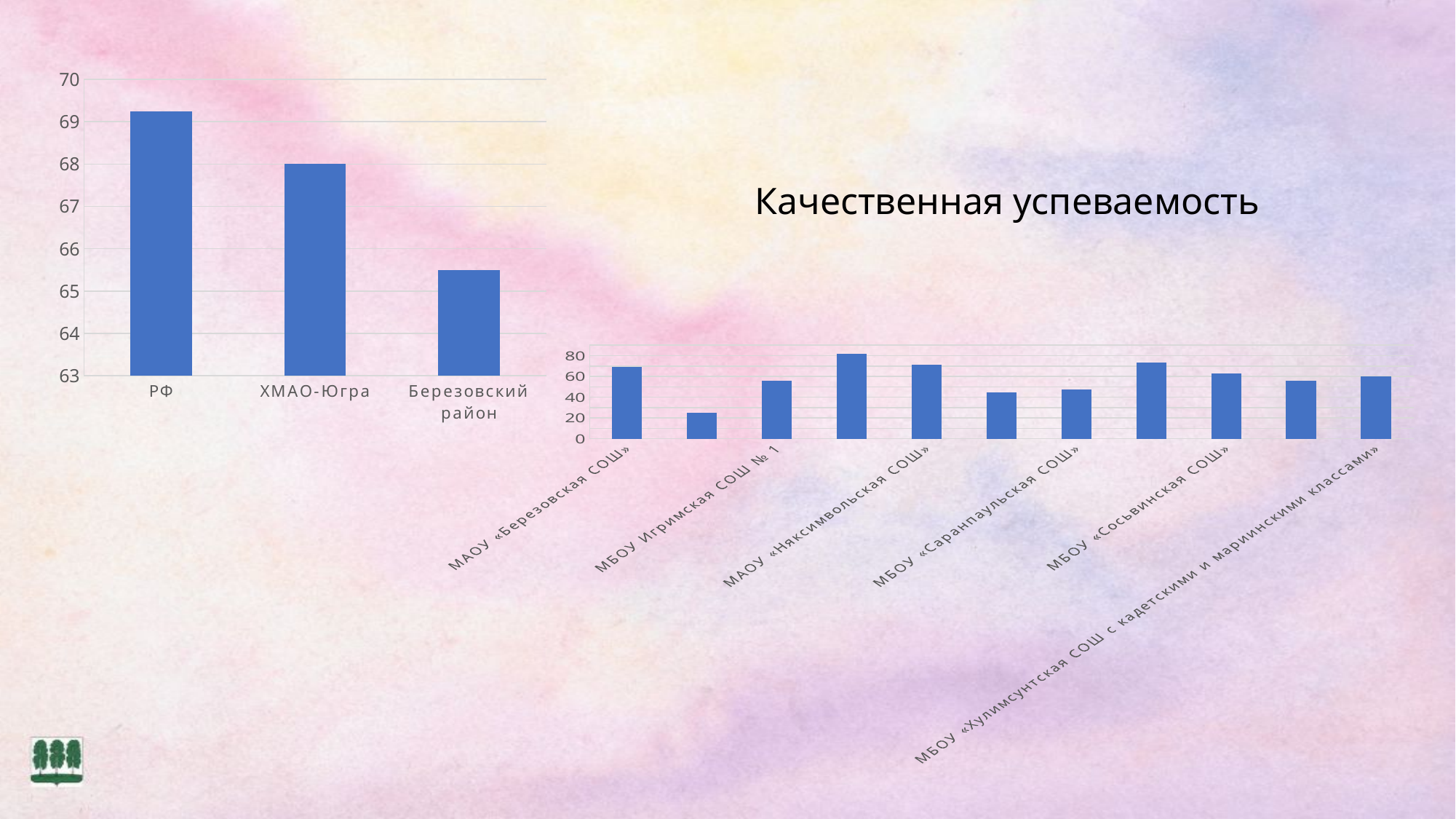
In the chart on the left of the slide, is the value for РФ greater or less than 69? greater How many bars does the chart on the right of the slide show? 11 How many categories does the chart on the left of the slide show? 3 In the chart on the left of the slide, which category has the highest value? РФ In the chart on the left of the slide, do the values rise or fall from left to right along the x axis? fall In the chart on the left of the slide, which category has the lowest value? Березовский район In the chart on the right of the slide, which labelled school has the highest value? МАОУ «Няксимвольская СОШ» What kind of chart is the chart on the left of the slide? bar chart In the chart on the left of the slide, is the value for Березовский район greater or less than 66? less What title is shown above the chart on the right of the slide? Качественная успеваемость In the chart on the right of the slide, is the value for МБОУ «Саранпаульская СОШ» greater or less than 60? less In the chart on the left of the slide, which is larger: the value for РФ or the value for ХМАО-Югра? РФ